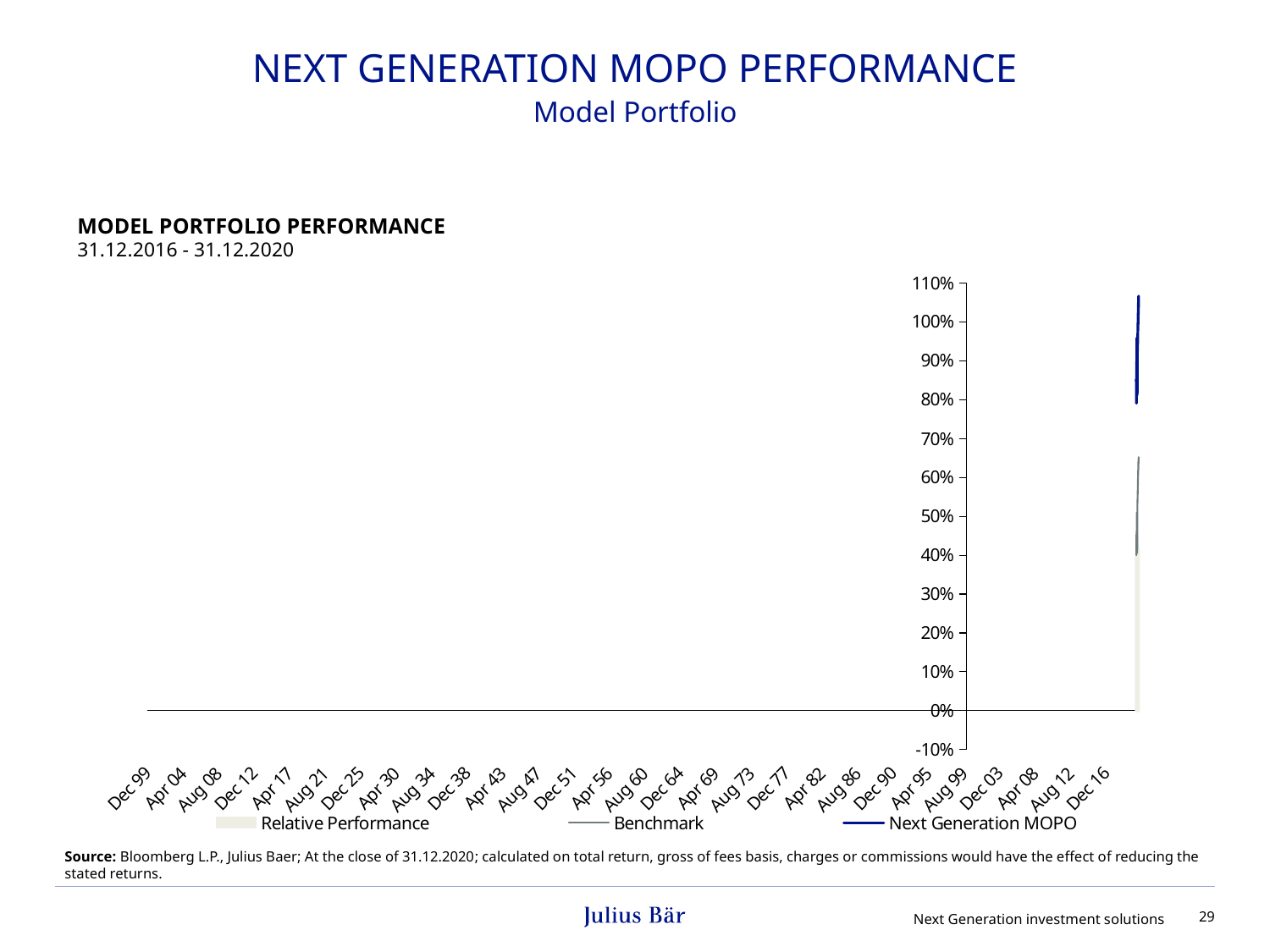
What is the lowest value shown on the chart's vertical axis? -10% How many series does the chart legend list? 3 What type of chart is shown on the slide? line chart Is the lowest point of the Next Generation MOPO line greater or less than 70%? greater What are the three series named in the chart legend? Relative Performance, Benchmark, Next Generation MOPO What is the title of the chart? MODEL PORTFOLIO PERFORMANCE Is the peak of the Next Generation MOPO line greater or less than 100%? greater What is the highest value shown on the chart's vertical axis? 110% Is the peak of the Benchmark line greater or less than 70%? less Which series is drawn in dark blue in the chart? Next Generation MOPO Which series is plotted higher on the chart, Benchmark or Next Generation MOPO? Next Generation MOPO